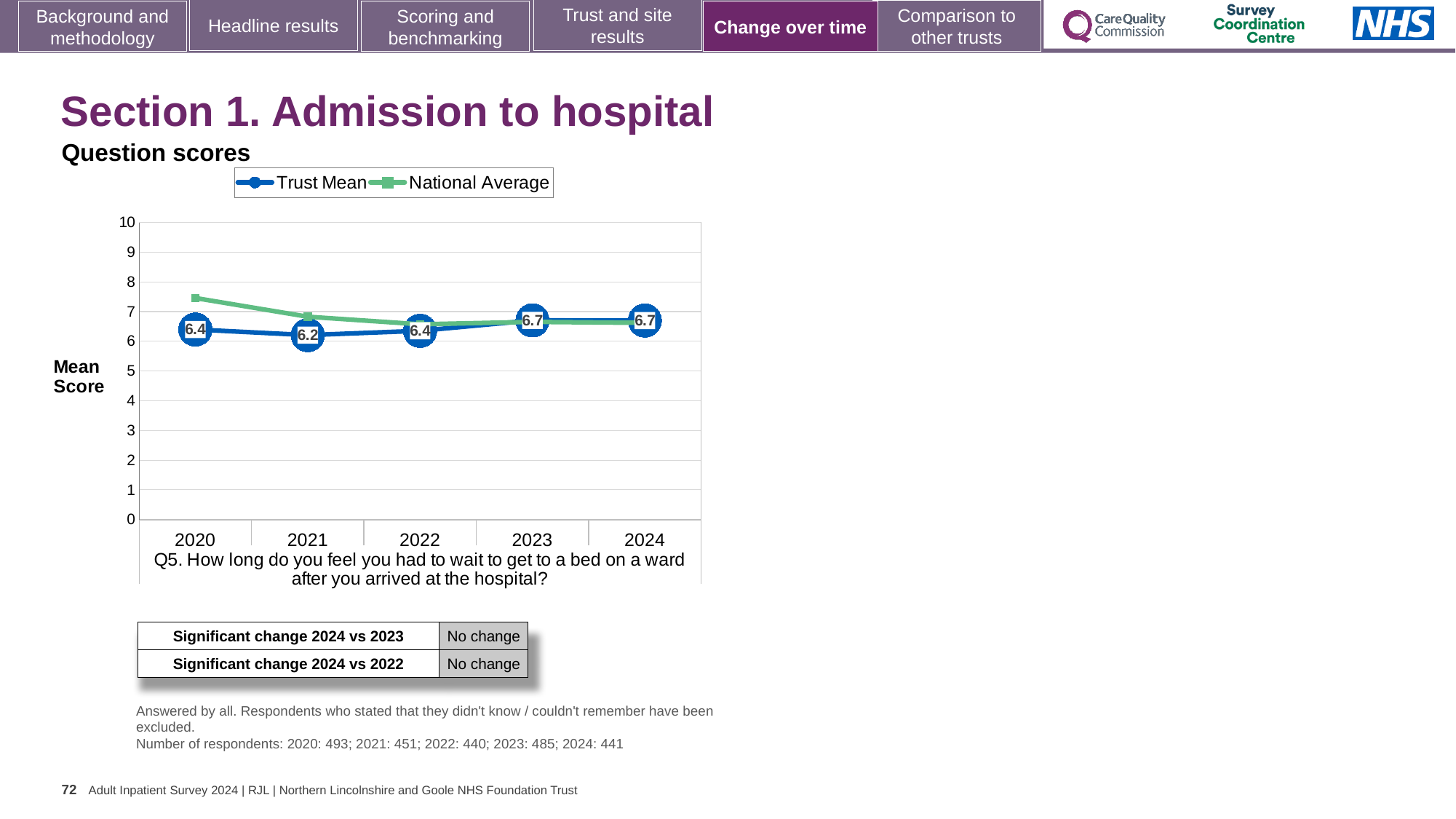
What is the Trust Mean score for 2020? 6.4 What kind of chart is shown on the slide? line chart What is the Trust Mean score for 2021? 6.2 Is the National Average value for 2020 greater or less than 7? greater Which is larger, the Trust Mean score for 2021 or for 2023? 2023 What are the two series named in the legend? Trust Mean and National Average What is the difference between the Trust Mean scores for 2024 and 2021? 0.5 How many series does the legend list? 2 What is the Trust Mean score for 2024? 6.7 Does the Trust Mean score rise or fall from 2021 to 2024? rise How many years are plotted on the x axis? 5 In which year is the Trust Mean score lowest? 2021